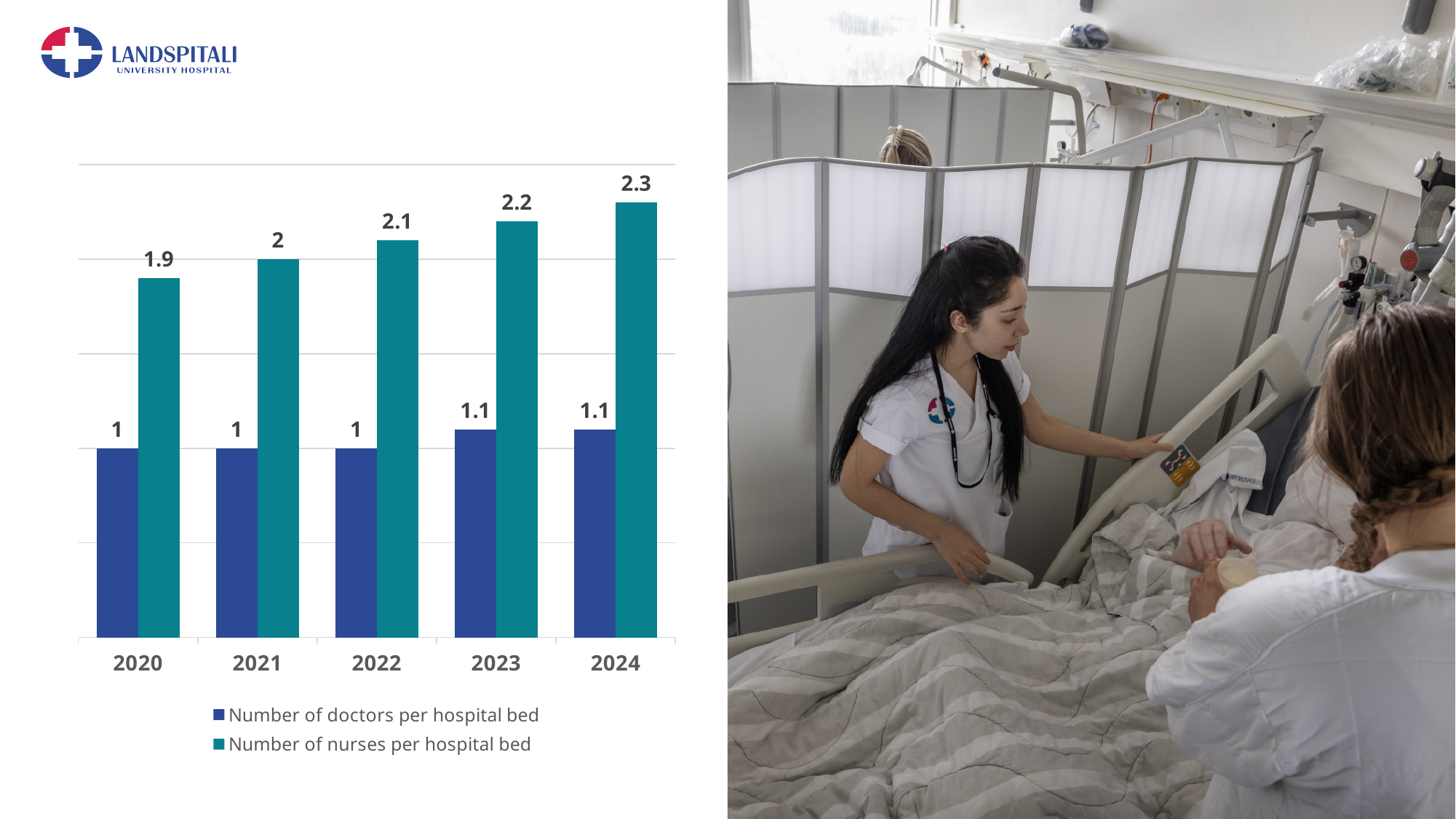
Does the number of nurses per hospital bed rise or fall from 2020 to 2024? Rise What is the number of nurses per hospital bed in 2024? 2.3 What is the number of nurses per hospital bed in 2020? 1.9 How many years are shown on the x axis of the chart? 5 What is the difference between the number of nurses per hospital bed in 2024 and in 2020? 0.4 What kind of chart is shown on the slide? Bar chart Which is larger in 2022: the number of doctors per hospital bed or the number of nurses per hospital bed? Number of nurses per hospital bed In which year is the number of nurses per hospital bed lowest? 2020 What is the number of doctors per hospital bed in 2021? 1 How many series does the chart legend list? 2 What is the difference between the number of nurses and the number of doctors per hospital bed in 2023? 1.1 In which year is the number of nurses per hospital bed highest? 2024